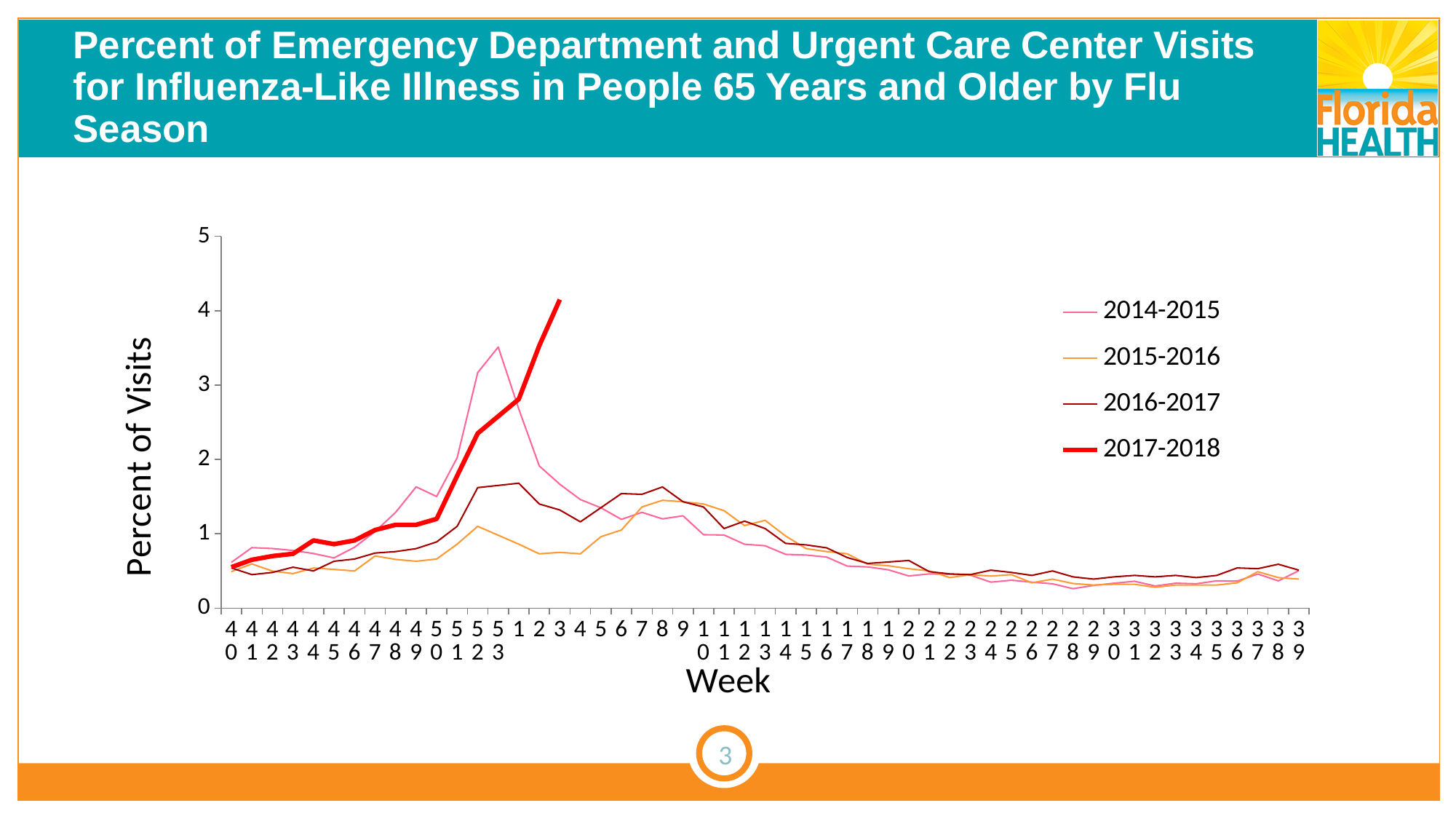
Which flu season reaches the highest value on the chart? 2017-2018 What is the label on the vertical axis? Percent of Visits At which week does the 2014-2015 line reach its peak? 53 Does the 2017-2018 line rise or fall from week 40 to week 3? rise How many flu seasons does the legend list? 4 Is the peak value for the 2017-2018 season greater or less than 3? greater Is the peak value for the 2015-2016 season greater or less than 2? less Which season reaches a higher peak, 2014-2015 or 2016-2017? 2014-2015 What kind of chart is shown on the slide? line chart Is the value for the 2014-2015 season at week 40 greater or less than 1? less Which flu season is drawn with the thick red line? 2017-2018